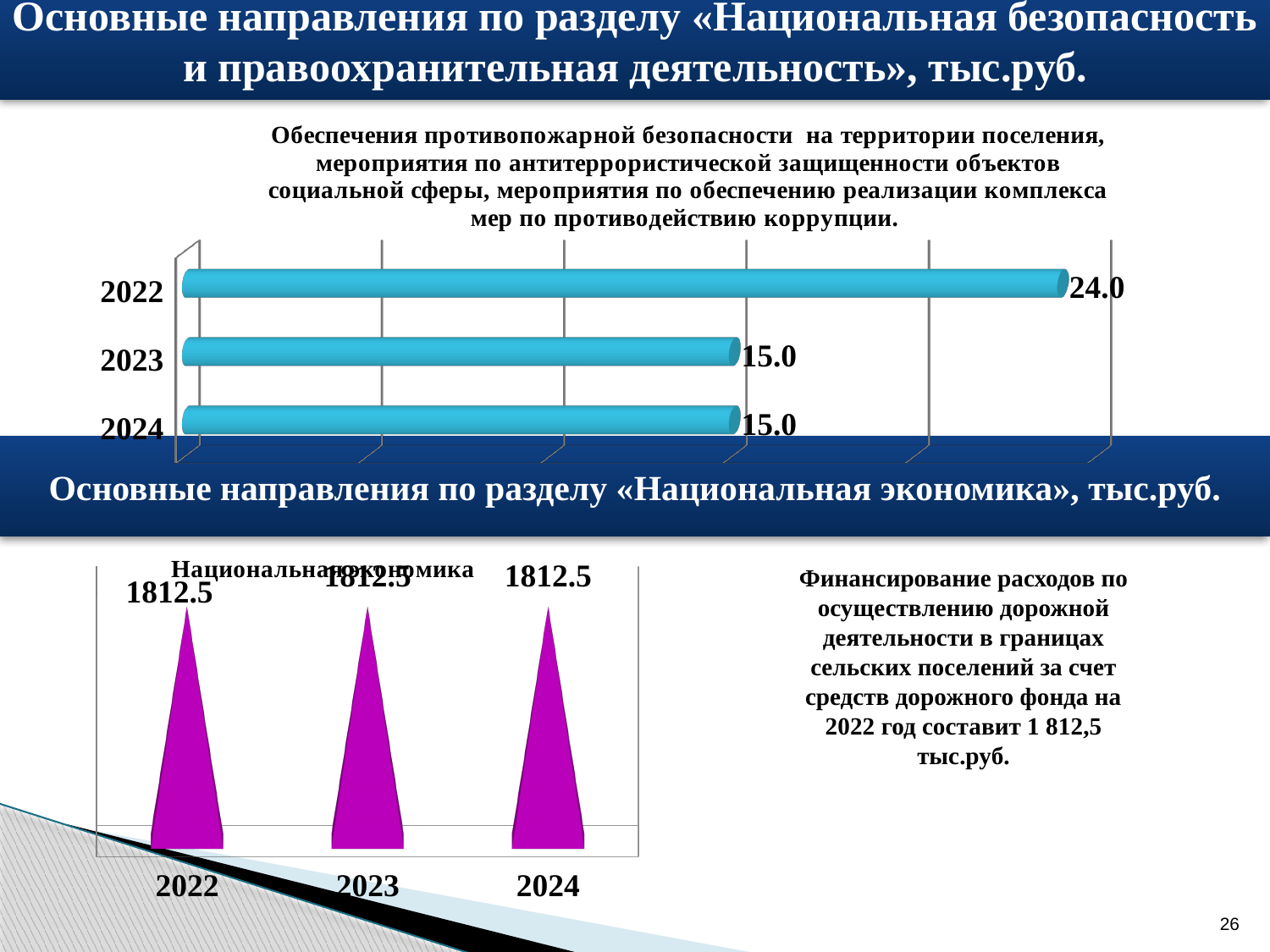
How many categories are shown in the bottom chart titled «Национальная экономика»? 3 In the top chart, which year has the highest value? 2022 In the bottom chart titled «Национальная экономика», what is the value for 2022? 1812.5 In the top chart (fire safety / anti-terrorism / anti-corruption measures), what is the value for 2022? 24.0 In the top chart, what is the value for 2024? 15.0 What kind of chart is the top chart? Bar chart In the top chart, what is the value for 2023? 15.0 In the top chart, which is larger, the value for 2022 or the value for 2024? 2022 In the top chart, what is the difference between the values for 2022 and 2023? 9.0 In the top chart, do the values rise or fall from 2022 to 2023? Fall How many years (categories) are shown in the top chart? 3 In the bottom chart titled «Национальная экономика», what is the value for 2024? 1812.5